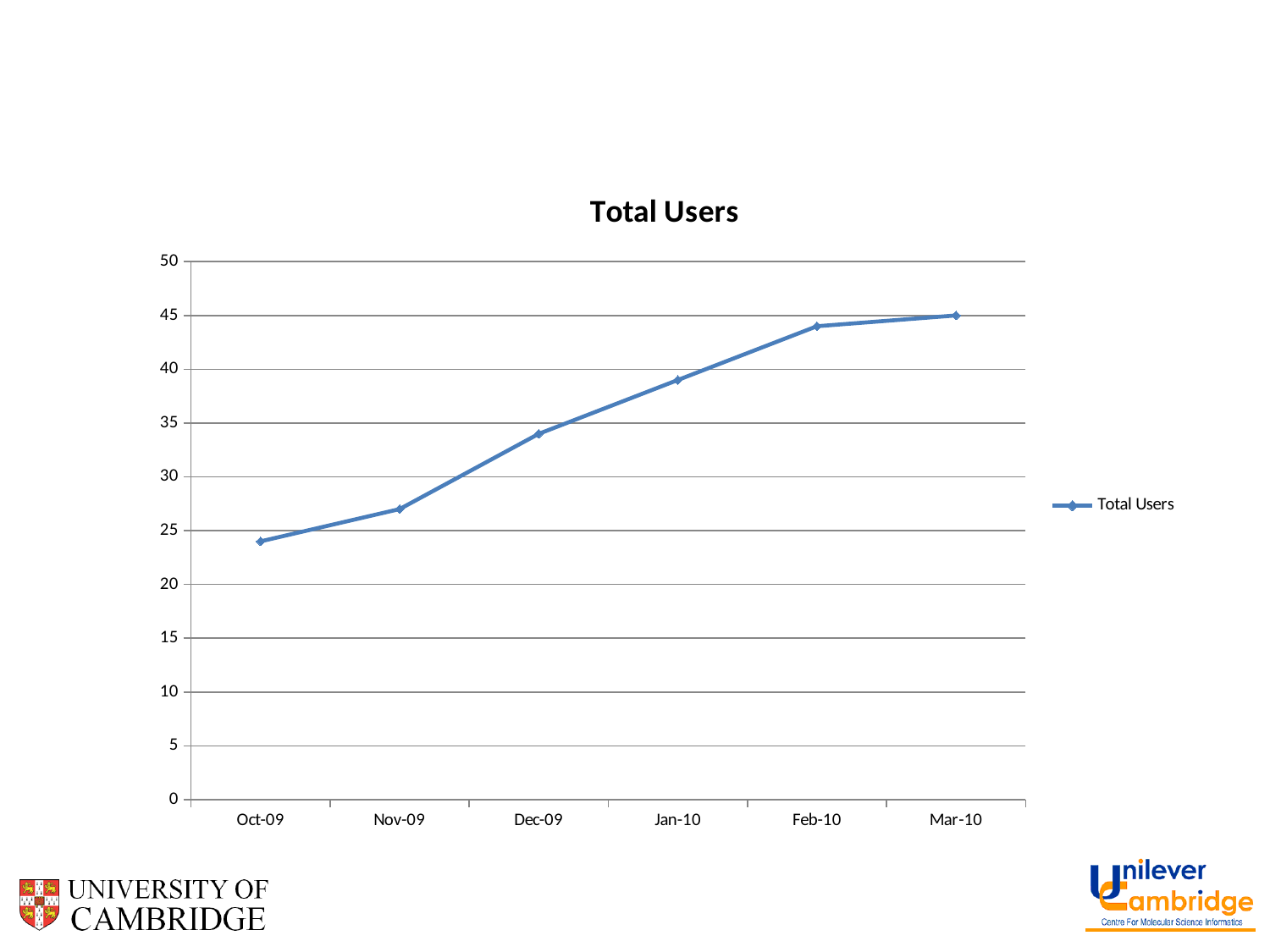
What is the value for Total Users in Mar-10? 45 What kind of chart is shown on the slide? line chart Is the value for Dec-09 greater or less than 30? greater How many points are plotted along the x axis? 6 Which is larger, the value for Nov-09 or the value for Feb-10? Feb-10 Which month has the highest value for Total Users? Mar-10 Is the value for Oct-09 greater or less than 25? less What is the title of the chart? Total Users Do the values rise or fall from Oct-09 to Mar-10? rise How many series does the legend list? 1 Is the value for Jan-10 greater or less than 40? less Which month has the lowest value for Total Users? Oct-09